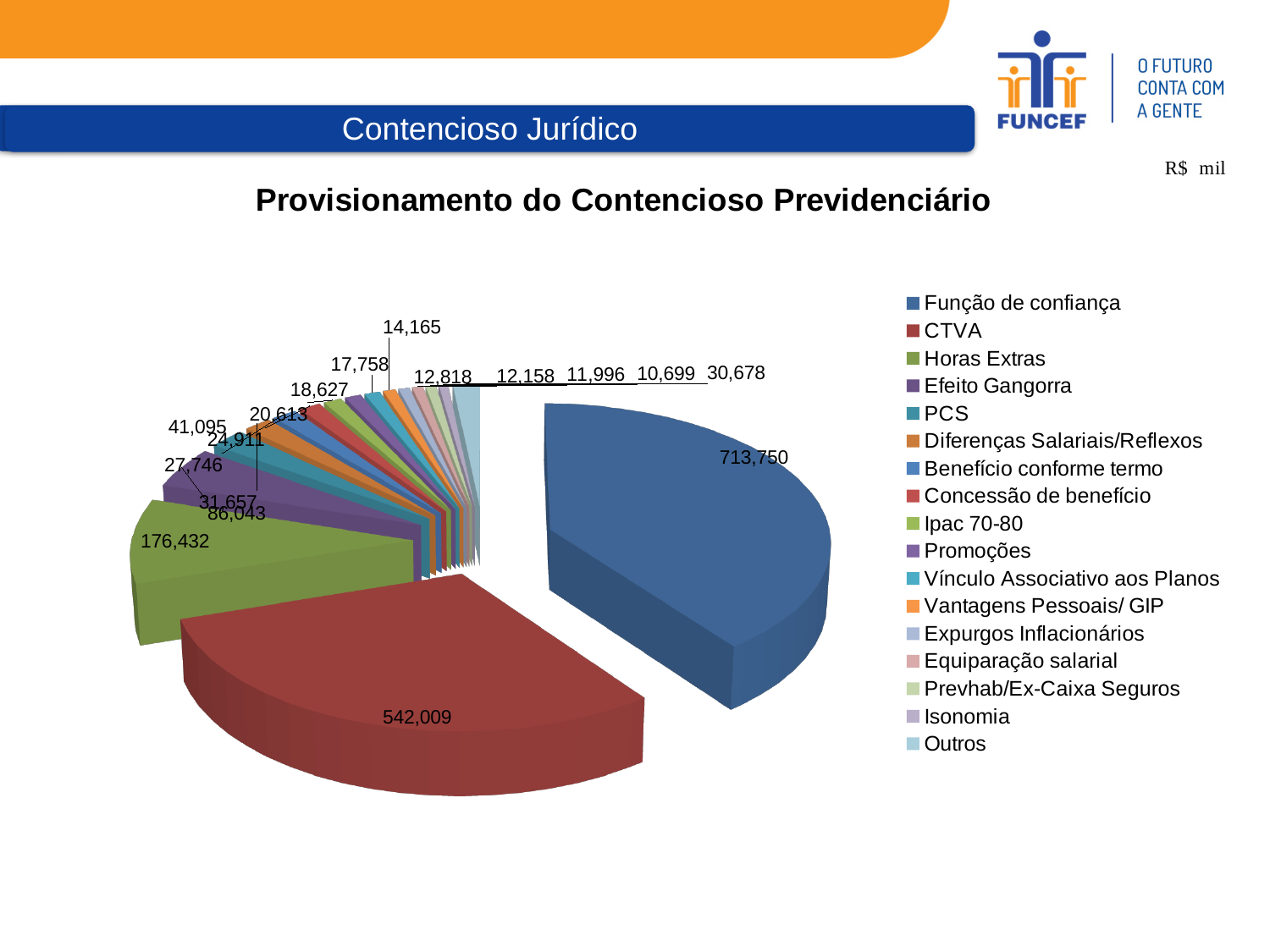
What is the difference between the values for Função de confiança and CTVA? 171,741 Which is larger, the value for Horas Extras or the value for Efeito Gangorra? Horas Extras What is the value for Função de confiança? 713,750 Which category has the largest slice of the pie? Função de confiança What is the smallest value labelled on the pie chart? 10,699 What type of chart is shown on the slide? pie chart What is the title of the chart? Provisionamento do Contencioso Previdenciário What is the value for CTVA? 542,009 What is the value for Outros? 30,678 How many categories does the legend of the pie chart list? 17 What is the value for Horas Extras? 176,432 What is the value for Efeito Gangorra? 86,043